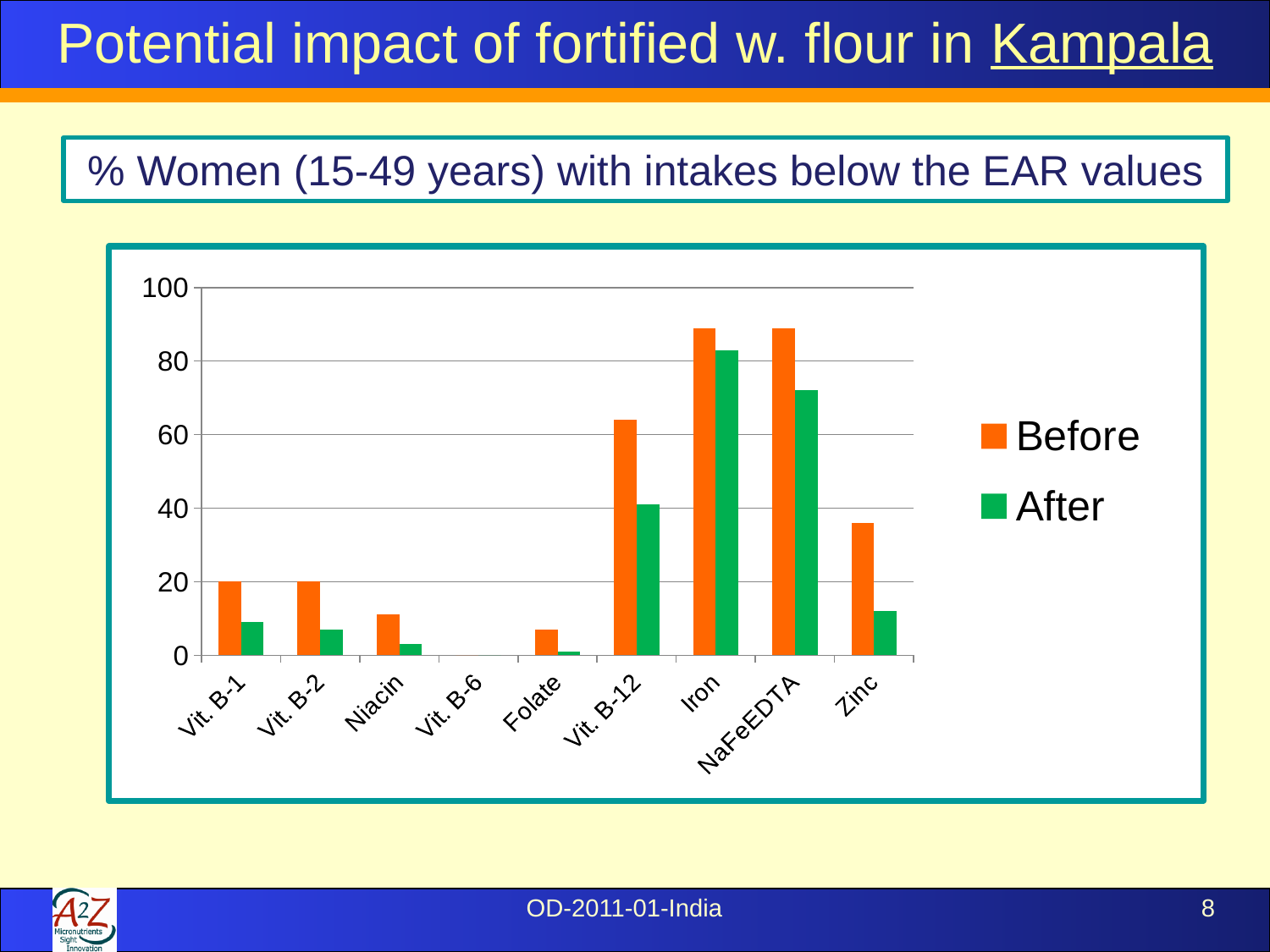
Is the After value for Vit. B-12 greater or less than 60? less How many categories are shown on the x axis? 9 Which category has the lowest Before value? Vit. B-6 Which series is shown in green in the legend? After What kind of chart is shown on the slide? bar chart Which category has the highest After value? Iron Is the Before value for Zinc greater or less than 20? greater Is the Before value for Vit. B-12 greater or less than 60? greater Which is larger for Zinc, the Before value or the After value? Before How many series does the legend list? 2